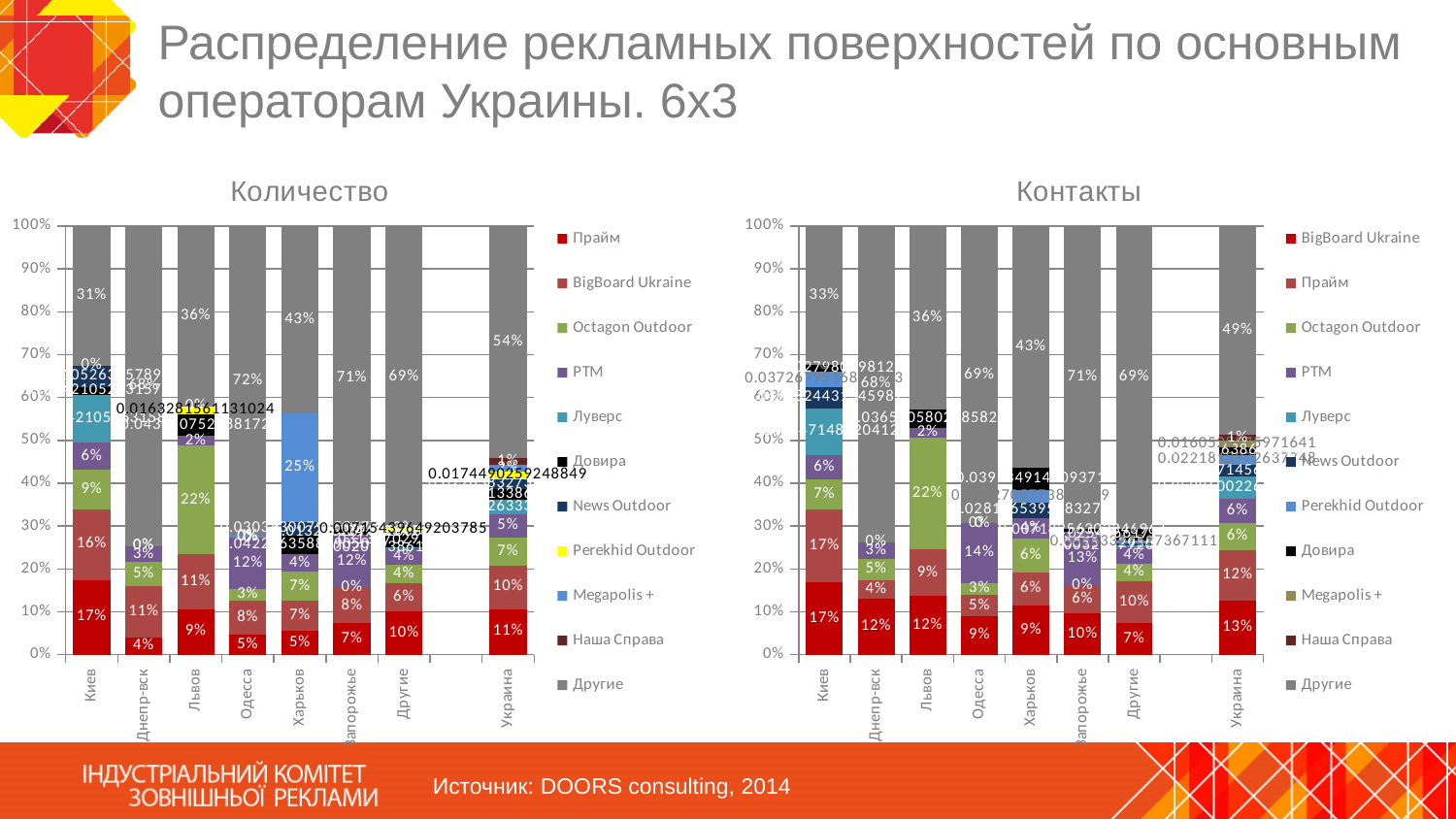
In the 'Количество' chart, what is the share of 'Прайм' for Киев? 17% What is the title of the chart on the right side of the slide? Контакты In the 'Контакты' chart, what is the share of 'Другие' for Украина? 49% What kind of chart is the 'Количество' chart on the left? Stacked bar chart How many categories are shown on the x axis of the 'Количество' chart? 8 In the 'Количество' chart, what is the share of 'Другие' for Одесса? 72% How many series does the legend of the 'Контакты' chart list? 11 In the 'Контакты' chart, what is the share of 'Octagon Outdoor' for Львов? 22% In the 'Контакты' chart, what is the share of 'BigBoard Ukraine' for Украина? 13% In the 'Количество' chart, what is the share of 'Megapolis +' for Харьков? 25% In the 'Количество' chart, what is the difference between the 'Другие' share for Украина and for Киев? 23 percentage points In the 'Контакты' chart, which has the larger 'Другие' share: Киев or Львов? Львов